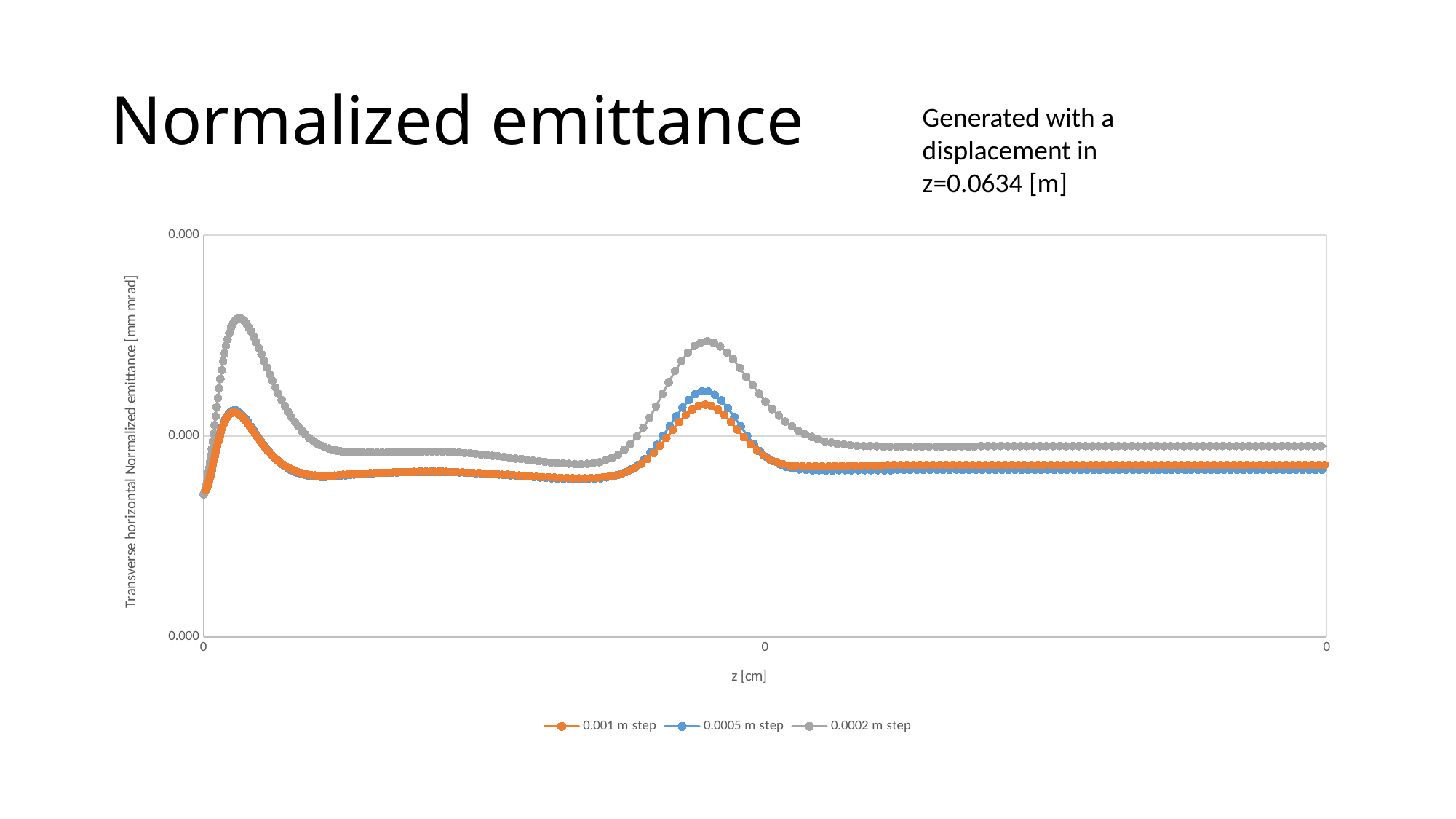
What kind of chart is shown on the slide? line chart What is the title of the x axis? z [cm] How many series does the legend list? 3 Starting from the left edge of the chart, do the values initially rise or fall? rise Which series has the highest values at the right-hand end of the chart? 0.0002 m step How many peaks does the 0.0002 m step series show? 2 Which series reaches the highest peak on the chart? 0.0002 m step What are the names of the series listed in the legend? 0.001 m step, 0.0005 m step, 0.0002 m step At the second peak, which series is higher: 0.0002 m step or 0.001 m step? 0.0002 m step Immediately after the second peak, do the values rise or fall as z increases? fall At the first peak, which series is higher: 0.0002 m step or 0.0005 m step? 0.0002 m step